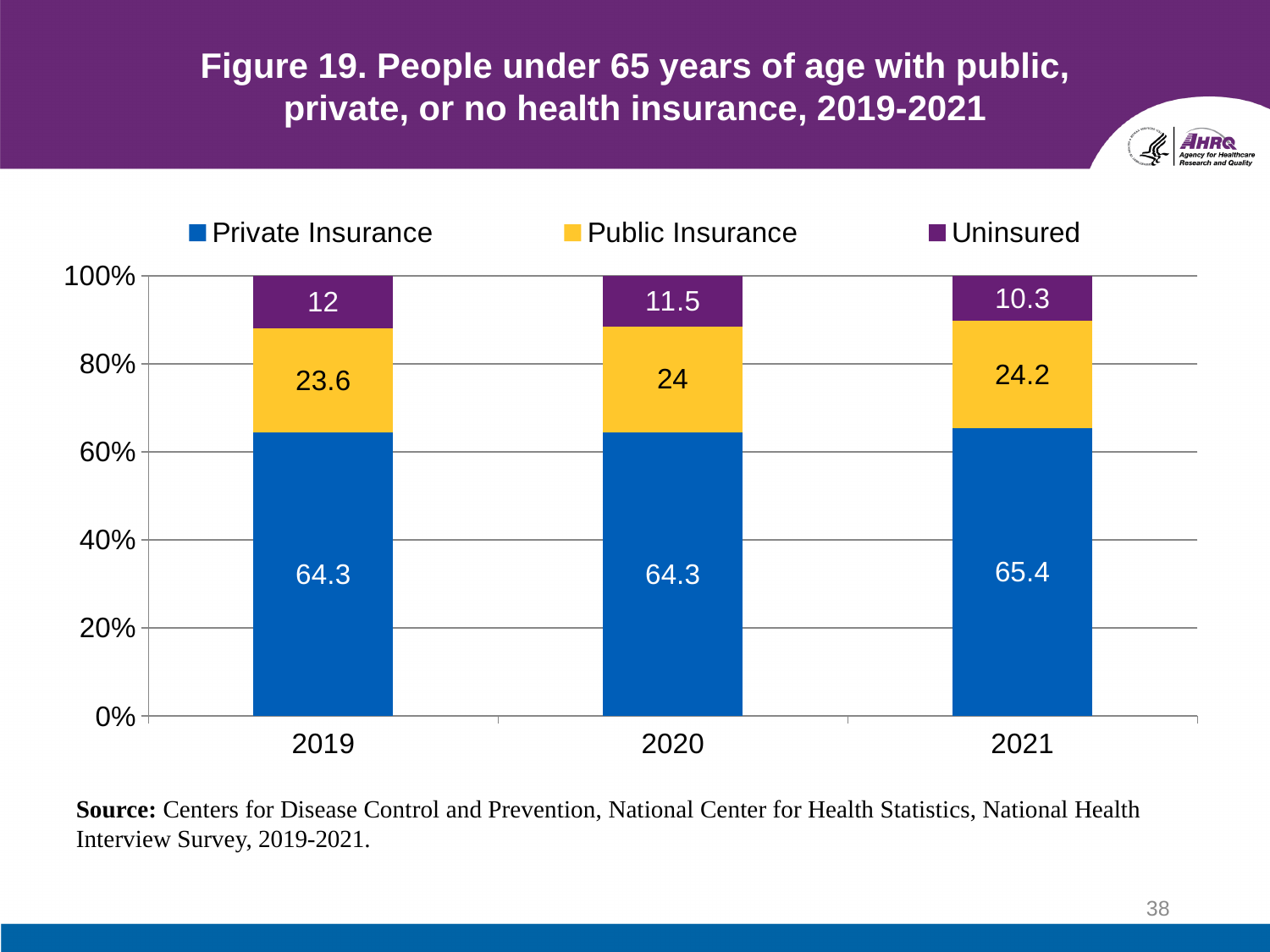
Which is larger, the Private Insurance value for 2021 or for 2020? 2021 In which year is the Uninsured value lowest? 2021 What is the value for Public Insurance in 2020? 24 What kind of chart is shown on the slide? Stacked bar chart What is the value for Private Insurance in 2021? 65.4 In which year is the Public Insurance value highest? 2021 What is the difference between the Uninsured values for 2019 and 2021? 1.7 How many series does the legend list? 3 What is the value for Uninsured in 2019? 12 Does the Uninsured value rise or fall from 2019 to 2021? Fall Which colour represents Public Insurance in the chart? Yellow How many years are shown on the x axis? 3